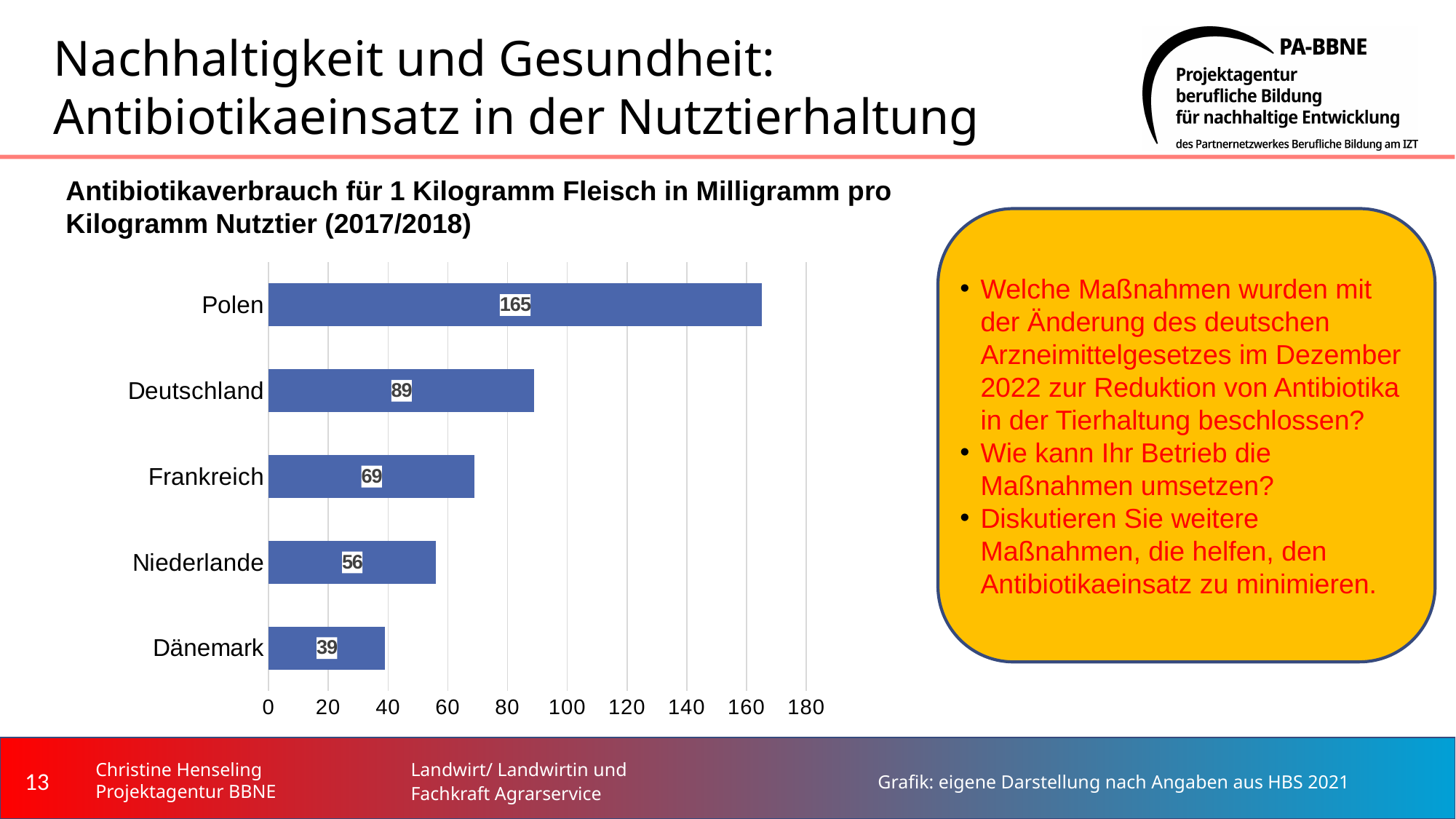
Which is larger, the value for Frankreich or the value for Niederlande? Frankreich What is the value for Deutschland? 89 What is the title of the chart? Antibiotikaverbrauch für 1 Kilogramm Fleisch in Milligramm pro Kilogramm Nutztier (2017/2018) What kind of chart is shown on the slide? bar chart Which country has the lowest antibiotic consumption? Dänemark What is the difference between the values for Polen and Deutschland? 76 What is the value for Niederlande? 56 Is the value for Deutschland greater or less than 80? greater Which country has the highest antibiotic consumption? Polen What is the value for Polen? 165 What is the difference between the values for Frankreich and Dänemark? 30 How many countries are shown in the chart? 5